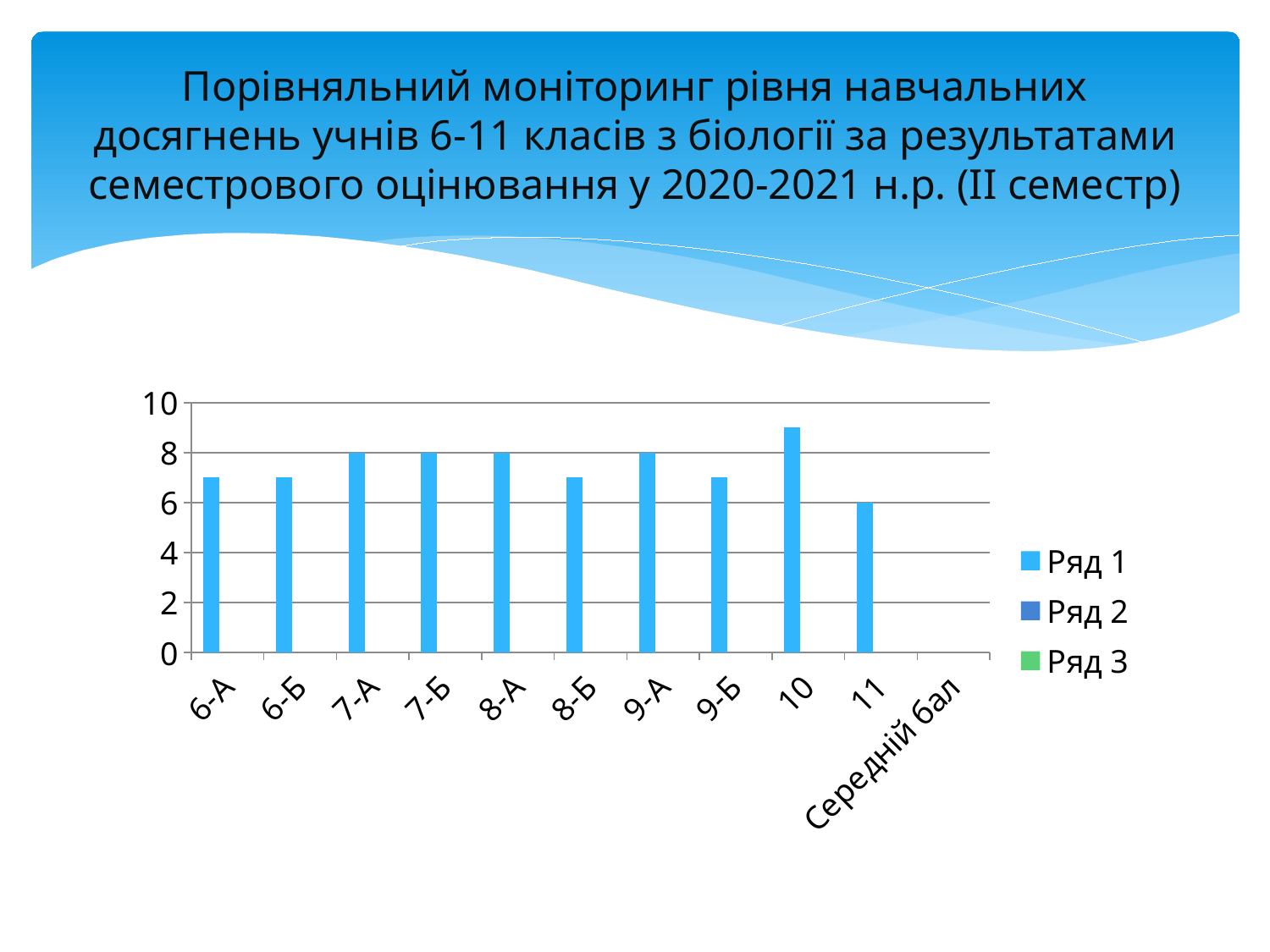
How many categories are labelled on the x axis? 11 Which category has the lowest bar among those with a bar? 11 Which is larger, the value for 10 or the value for 7-Б? 10 What is the value for 9-А? 8 Which category has the highest bar? 10 Is the value for 6-А greater or less than 8? less How many series does the legend list? 3 What is the value for 7-А? 8 Is the value for 10 greater or less than 8? greater What is the difference between the values for 7-А and 11? 2 What is the value for 11? 6 What type of chart is shown on the slide? bar chart